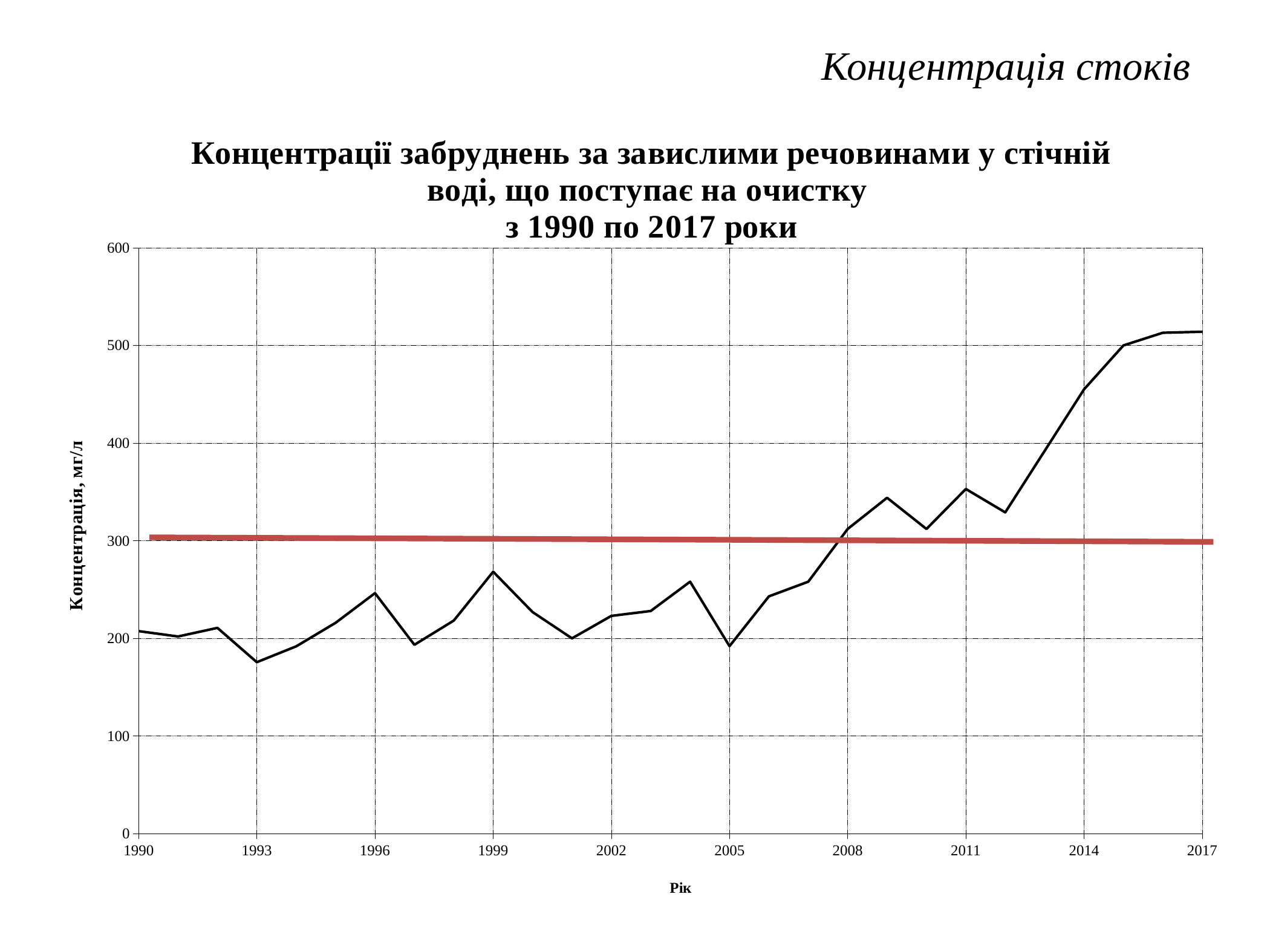
Is the concentration value for 2005 greater or less than 200? less Overall, does the concentration rise or fall from 1990 to 2017? rise Is the concentration value for 1993 greater or less than 200? less Which year has the larger concentration, 1990 or 2014? 2014 What is the label of the vertical axis? Концентрація, мг/л Is the concentration value for 1999 greater or less than 300? less What is the label of the horizontal axis? Рік What kind of chart is shown on the slide? line chart Which year has the lowest concentration on the black line? 1993